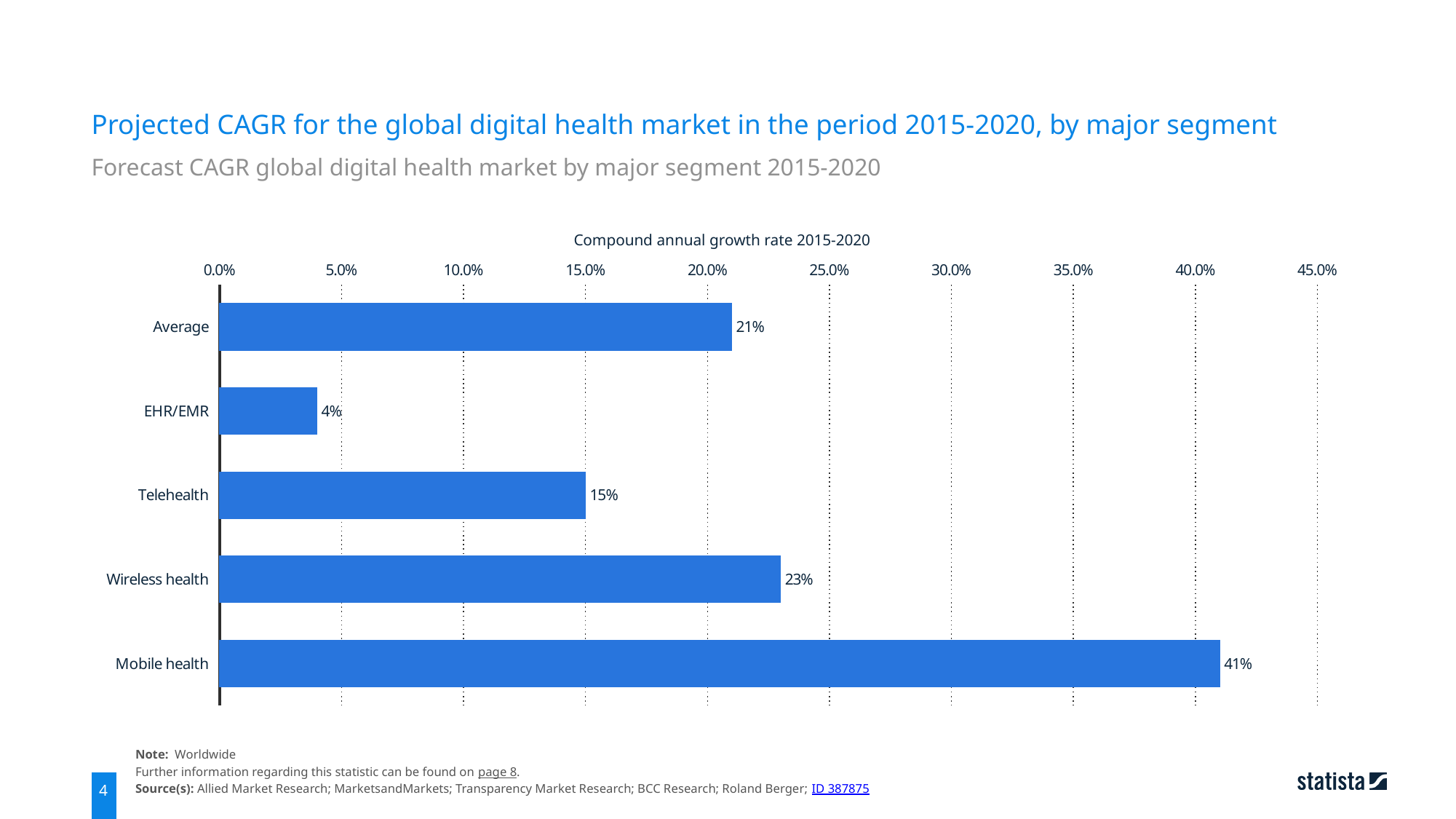
Which segment has the highest projected CAGR? Mobile health Is the value for Mobile health greater or less than 40.0%? greater Which segment has the lowest projected CAGR? EHR/EMR How many categories are shown in the chart? 5 What kind of chart is shown on the slide? Bar chart What is the difference between the projected CAGR for Mobile health and Wireless health? 18% What is the projected CAGR for Wireless health? 23% What is the projected CAGR for EHR/EMR? 4% What is the projected CAGR for Telehealth? 15% What is the projected CAGR for Mobile health? 41% Which has a higher projected CAGR, Wireless health or Average? Wireless health What is the title of the horizontal axis? Compound annual growth rate 2015-2020